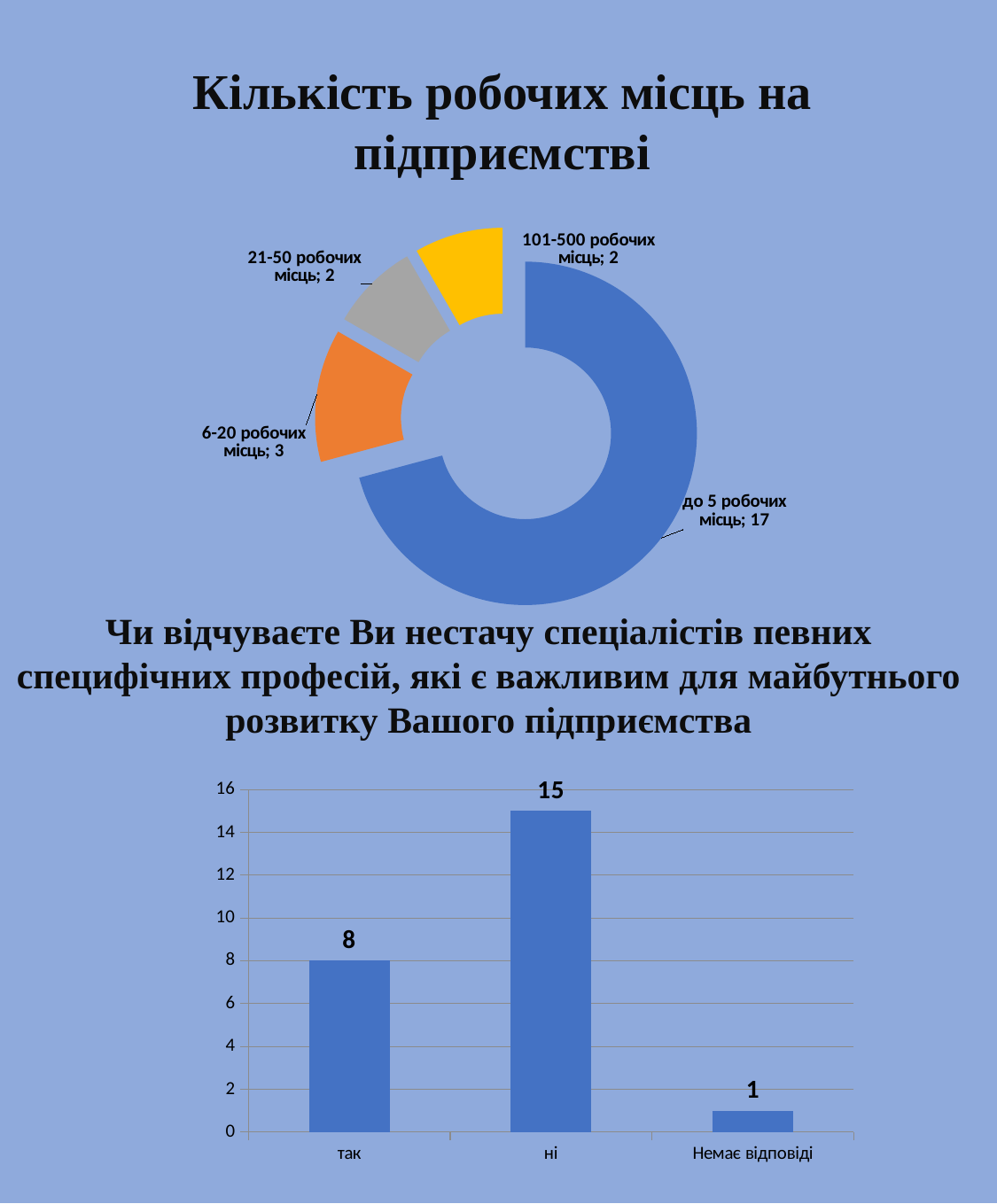
In the doughnut chart 'Кількість робочих місць на підприємстві', what is the total of all the categories? 24 In the bar chart at the bottom of the slide, which category has the lowest value? Немає відповіді In the bar chart at the bottom of the slide, what is the difference between the values for 'ні' and 'так'? 7 In the doughnut chart 'Кількість робочих місць на підприємстві', which category has the largest value? до 5 робочих місць What kind of chart is the top chart on the slide? Doughnut chart In the doughnut chart 'Кількість робочих місць на підприємстві', how many categories are shown? 4 In the doughnut chart 'Кількість робочих місць на підприємстві', what is the difference between the values for 'до 5 робочих місць' and '6-20 робочих місць'? 14 In the bar chart at the bottom of the slide, what is the value for 'ні'? 15 In the doughnut chart 'Кількість робочих місць на підприємстві', what is the value for 'до 5 робочих місць'? 17 What kind of chart is the bottom chart on the slide? Bar chart In the bar chart at the bottom of the slide, which is larger, the value for 'так' or the value for 'ні'? ні In the doughnut chart 'Кількість робочих місць на підприємстві', what is the value for '6-20 робочих місць'? 3